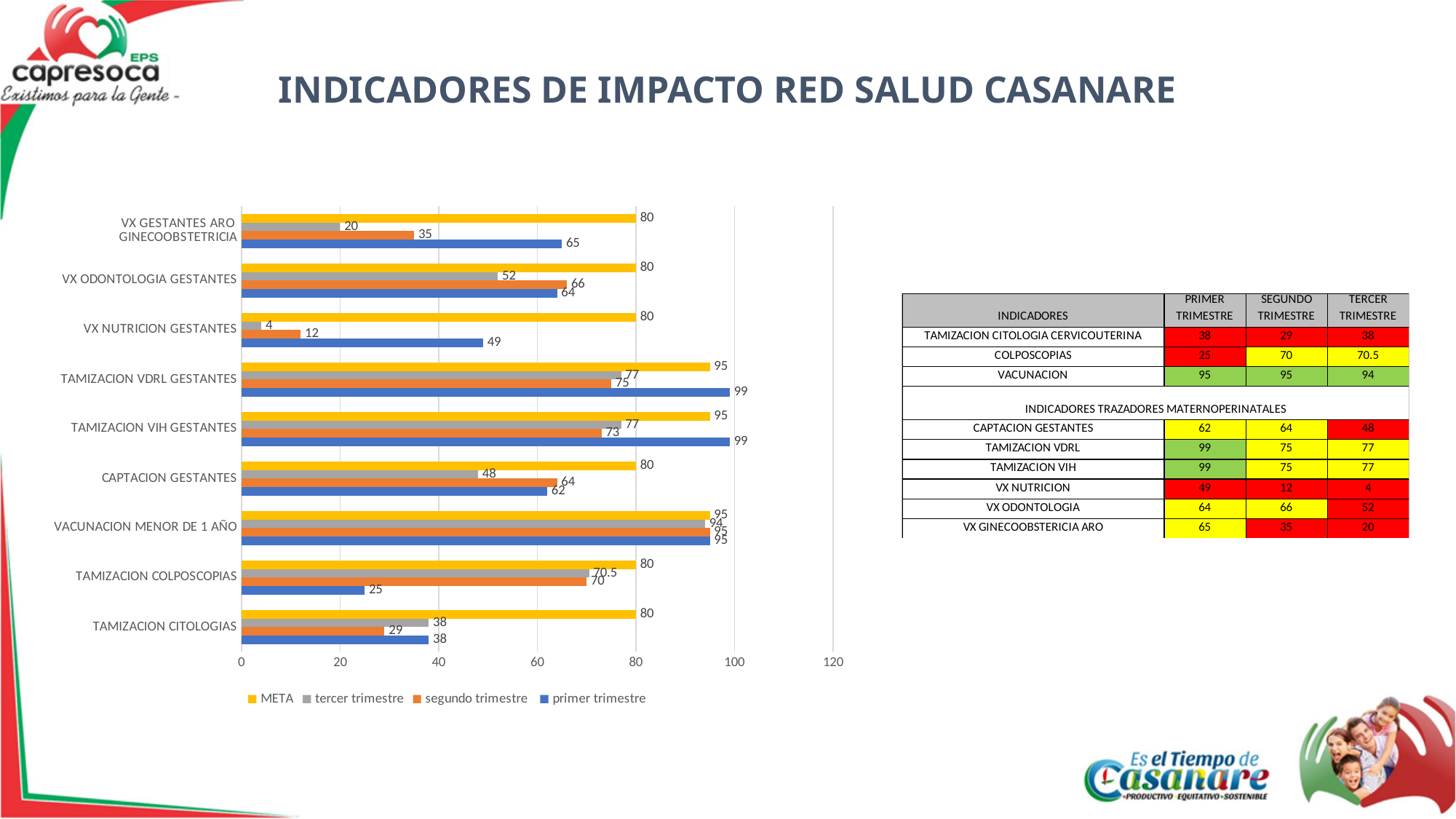
How many series does the chart legend list? 4 What is the primer trimestre value for VX NUTRICION GESTANTES? 49 Which category has the highest primer trimestre value? TAMIZACION VDRL GESTANTES and TAMIZACION VIH GESTANTES (99) What is the META value for TAMIZACION VDRL GESTANTES? 95 Which is larger for TAMIZACION CITOLOGIAS: the primer trimestre value or the segundo trimestre value? primer trimestre What is the difference between the META and the tercer trimestre value for CAPTACION GESTANTES? 32 How many categories are plotted on the chart? 9 What type of chart is shown on the slide? bar chart Which series is shown in orange in the chart legend? segundo trimestre What is the tercer trimestre value for TAMIZACION COLPOSCOPIAS? 70.5 Which category has the lowest tercer trimestre value? VX NUTRICION GESTANTES What is the segundo trimestre value for VX GESTANTES ARO GINECOOBSTETRICIA? 35